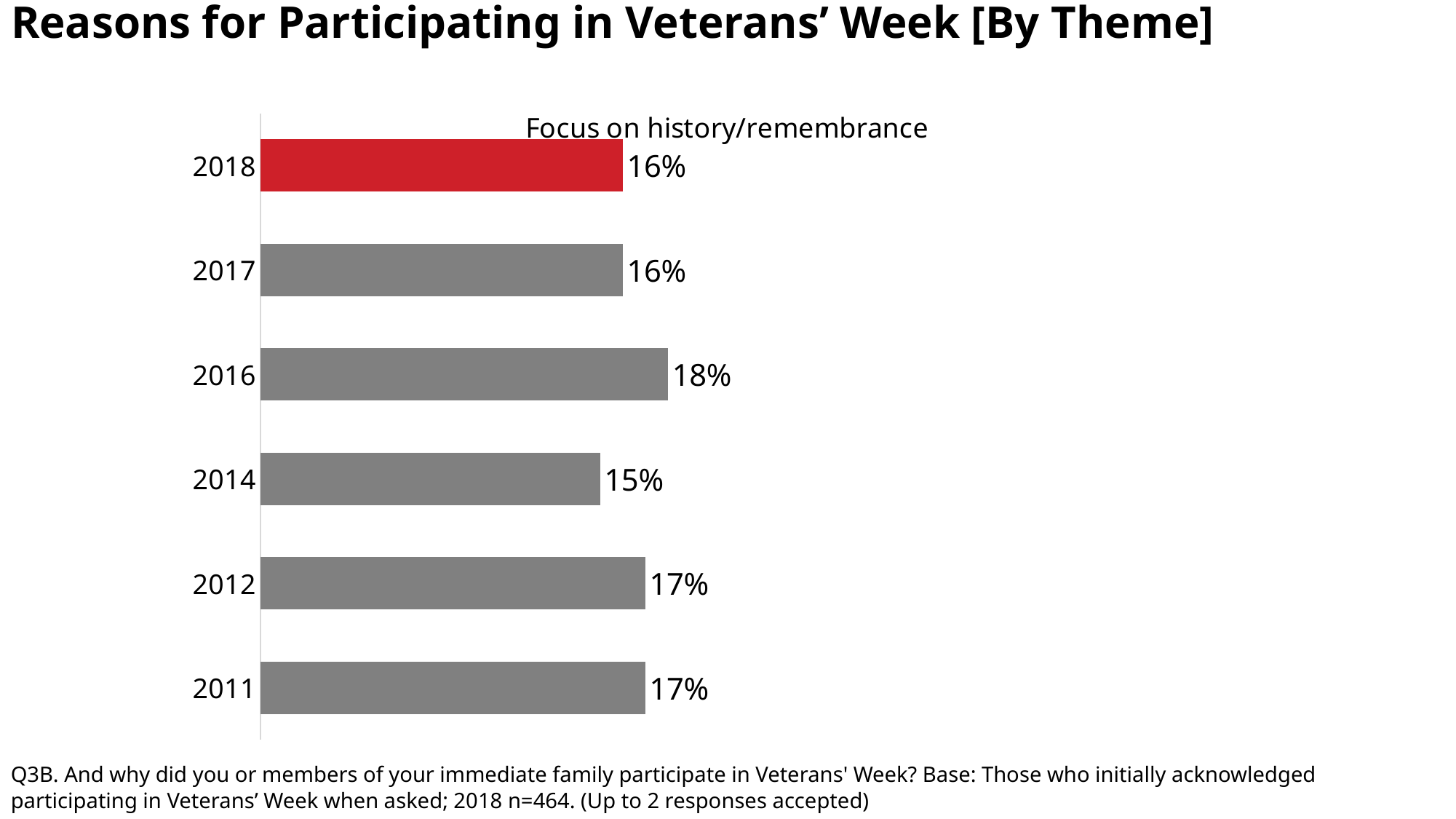
What is the difference between the values for 2012 and 2018? 1% What kind of chart is shown on the slide? Bar chart Which year's bar is coloured red? 2018 What is the value for 2018 in the Focus on history/remembrance chart? 16% What is the value for 2016? 18% Which year has the highest value? 2016 What is the value for 2014? 15% What is the value for 2011? 17% How many years are shown in the chart? 6 Which is larger, the value for 2016 or the value for 2017? 2016 Which year has the lowest value? 2014 What is the difference between the values for 2016 and 2014? 3%